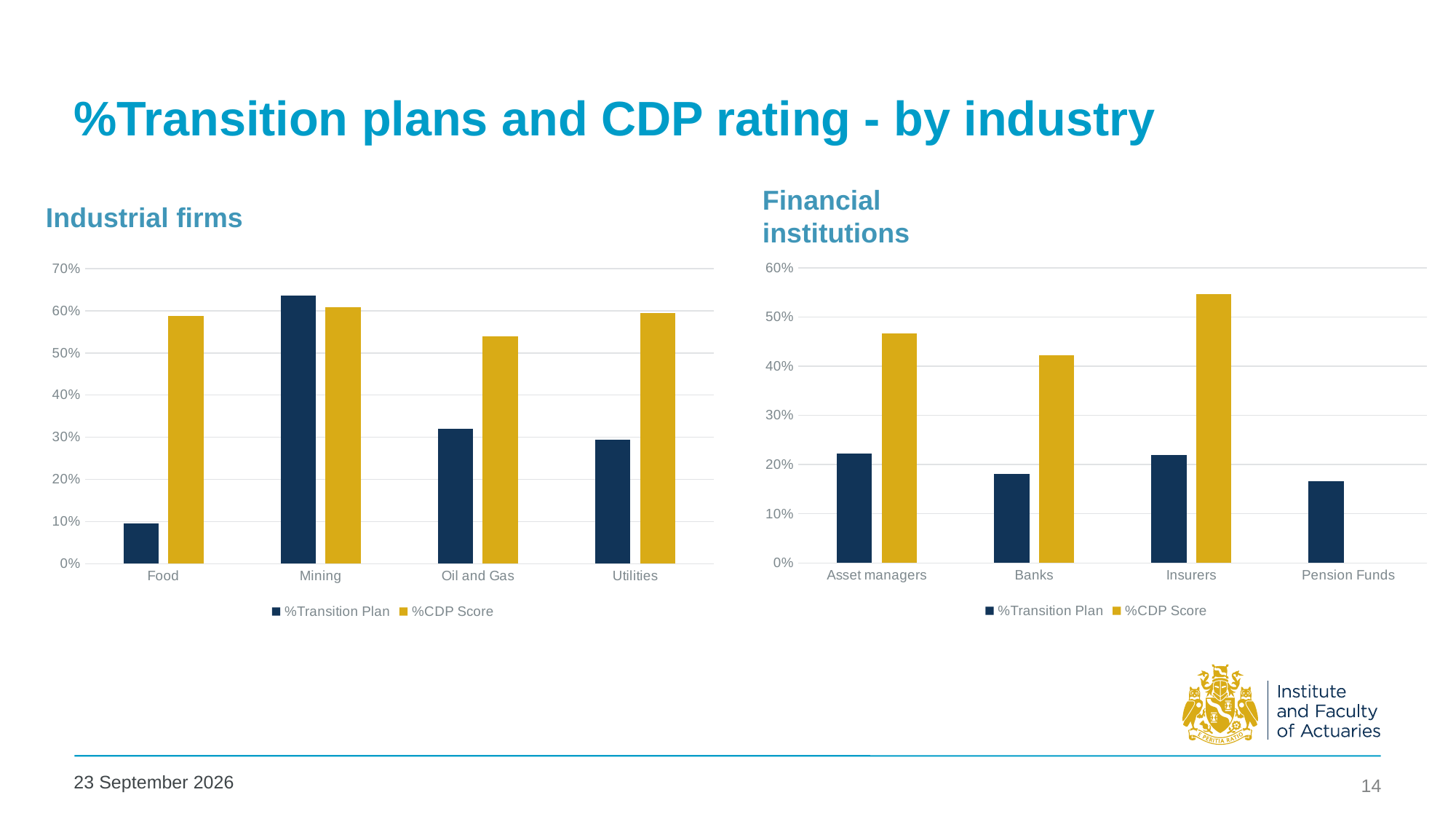
On the Industrial firms chart, which category has the highest %Transition Plan value? Mining How many categories are shown on the Financial institutions chart? 4 How many series does the legend of the Industrial firms chart list? 2 On the Industrial firms chart, is the %Transition Plan value for Food greater or less than 20%? less On the Industrial firms chart, which category has the lowest %Transition Plan value? Food On the Financial institutions chart, is the %CDP Score value for Insurers greater or less than 50%? greater On the Industrial firms chart, is the %CDP Score value for Oil and Gas greater or less than 50%? greater On the Financial institutions chart, which category has the highest %CDP Score value? Insurers On the Industrial firms chart, which is larger for Utilities: %Transition Plan or %CDP Score? %CDP Score What type of chart is the Industrial firms chart? Bar chart